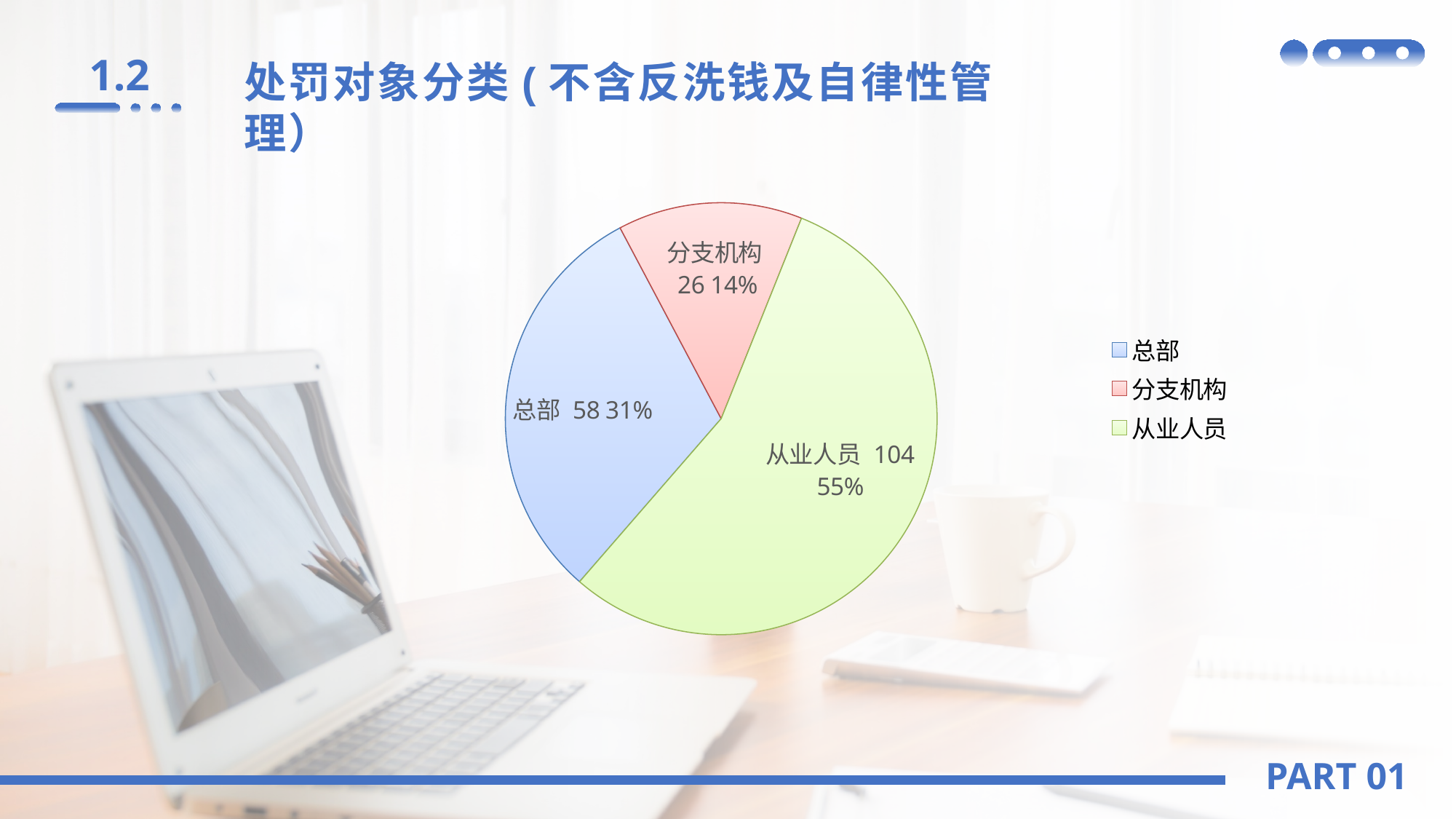
How many slices does the pie chart have? 3 What is the difference between the values for 从业人员 and 总部? 46 What share of the pie does 从业人员 represent? 55% Which category has the smallest slice in the pie chart? 分支机构 How many entries does the legend list? 3 What share of the pie does 分支机构 represent? 14% What kind of chart is shown on the slide? pie chart Which is larger, the value for 总部 or the value for 分支机构? 总部 Which category has the largest slice in the pie chart? 从业人员 What is the value for 分支机构 in the pie chart? 26 What is the value for 总部 in the pie chart? 58 What is the value for 从业人员 in the pie chart? 104